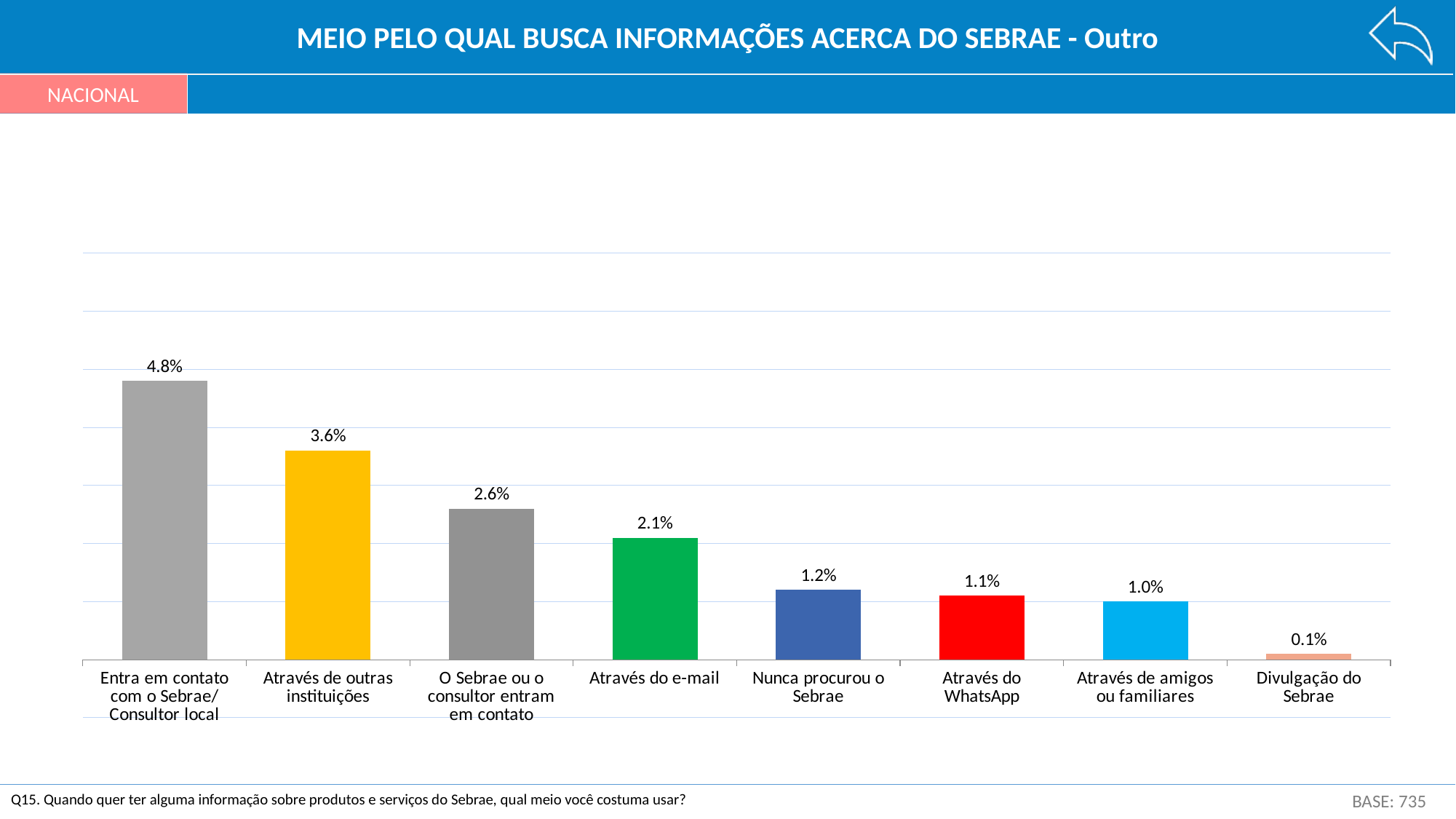
Which category has the highest value? Entra em contato com o Sebrae/ Consultor local What is the difference between "Nunca procurou o Sebrae" and "Através de amigos ou familiares"? 0.2% Which is larger: "O Sebrae ou o consultor entram em contato" or "Através do e-mail"? O Sebrae ou o consultor entram em contato What is the title of the chart? MEIO PELO QUAL BUSCA INFORMAÇÕES ACERCA DO SEBRAE - Outro Do the values rise or fall from left to right along the x axis? Fall What is the value for "Divulgação do Sebrae"? 0.1% What is the value for "Através do e-mail"? 2.1% How many categories are shown in the chart? 8 Which category has the lowest value? Divulgação do Sebrae What is the difference between "Entra em contato com o Sebrae/ Consultor local" and "Através de outras instituições"? 1.2% What kind of chart is shown on the slide? Bar chart What is the value for "Através do WhatsApp"? 1.1%